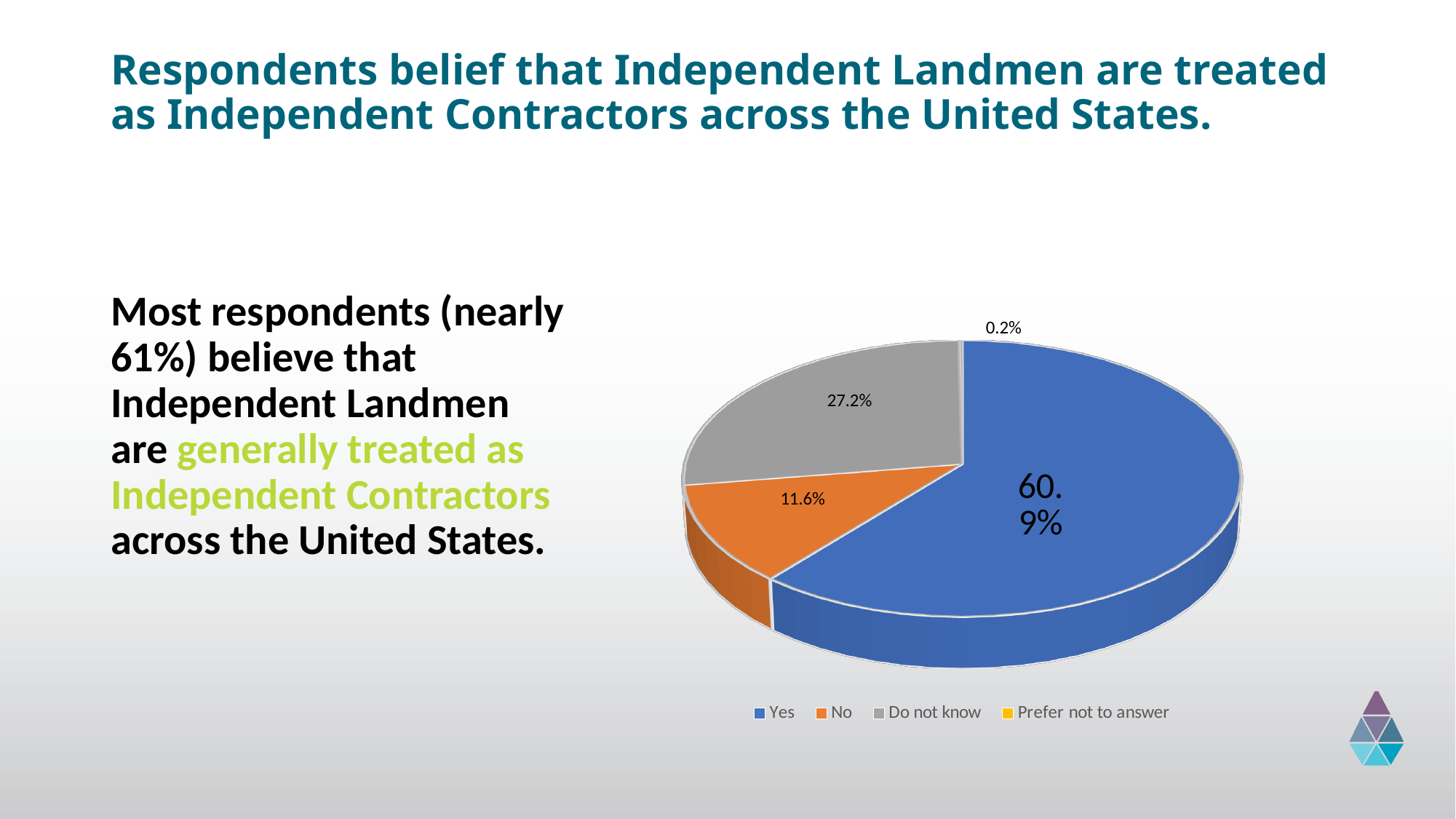
What percentage of respondents chose "Prefer not to answer"? 0.2% What percentage of respondents answered "Do not know"? 27.2% What percentage of respondents answered "Yes"? 60.9% What is the difference in percentage points between the "Do not know" and "No" slices? 15.6 What type of chart is shown on the slide? Pie chart What colour is the "Do not know" slice? Gray Which is larger, the "No" slice or the "Do not know" slice? Do not know Which response category has the smallest share of the pie? Prefer not to answer What colour represents the "Yes" category in the legend? Blue How many response categories does the legend list? 4 Which response category has the largest share of the pie? Yes What percentage of respondents answered "No"? 11.6%